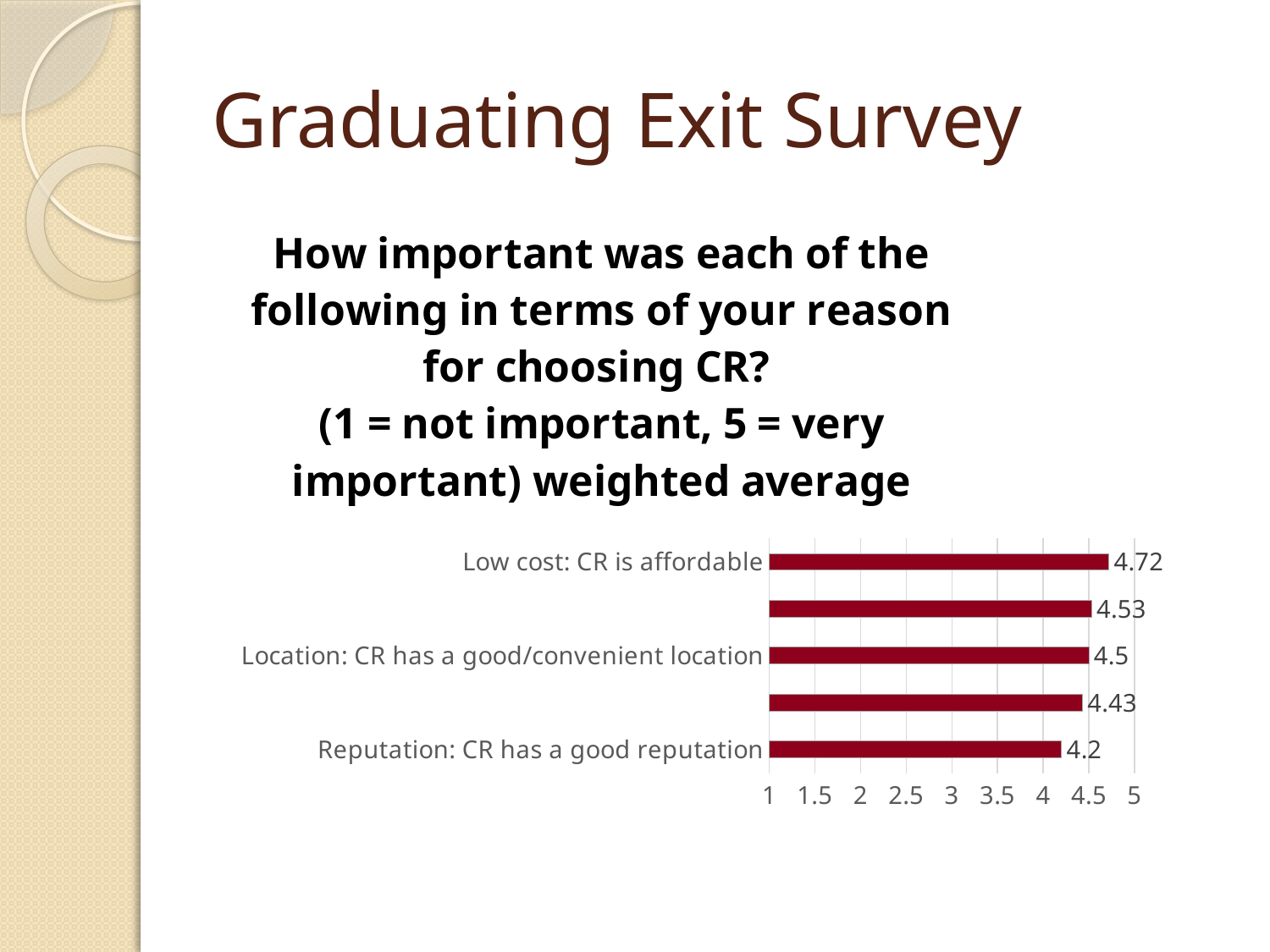
What kind of chart is shown on the slide? Bar chart What is the highest value shown on the chart's value axis? 5 Which category has the lowest weighted average? Reputation: CR has a good reputation What is the difference between the weighted averages for "Low cost: CR is affordable" and "Reputation: CR has a good reputation"? 0.52 Is the value for "Reputation: CR has a good reputation" greater or less than 4.5? less Which category has the highest weighted average? Low cost: CR is affordable Which has a higher weighted average, "Location: CR has a good/convenient location" or "Reputation: CR has a good reputation"? Location: CR has a good/convenient location What is the weighted average for "Location: CR has a good/convenient location"? 4.5 What is the weighted average for "Low cost: CR is affordable"? 4.72 How many bars are plotted in the chart? 5 What is the weighted average for "Reputation: CR has a good reputation"? 4.2 What is the difference between the weighted averages for "Low cost: CR is affordable" and "Location: CR has a good/convenient location"? 0.22